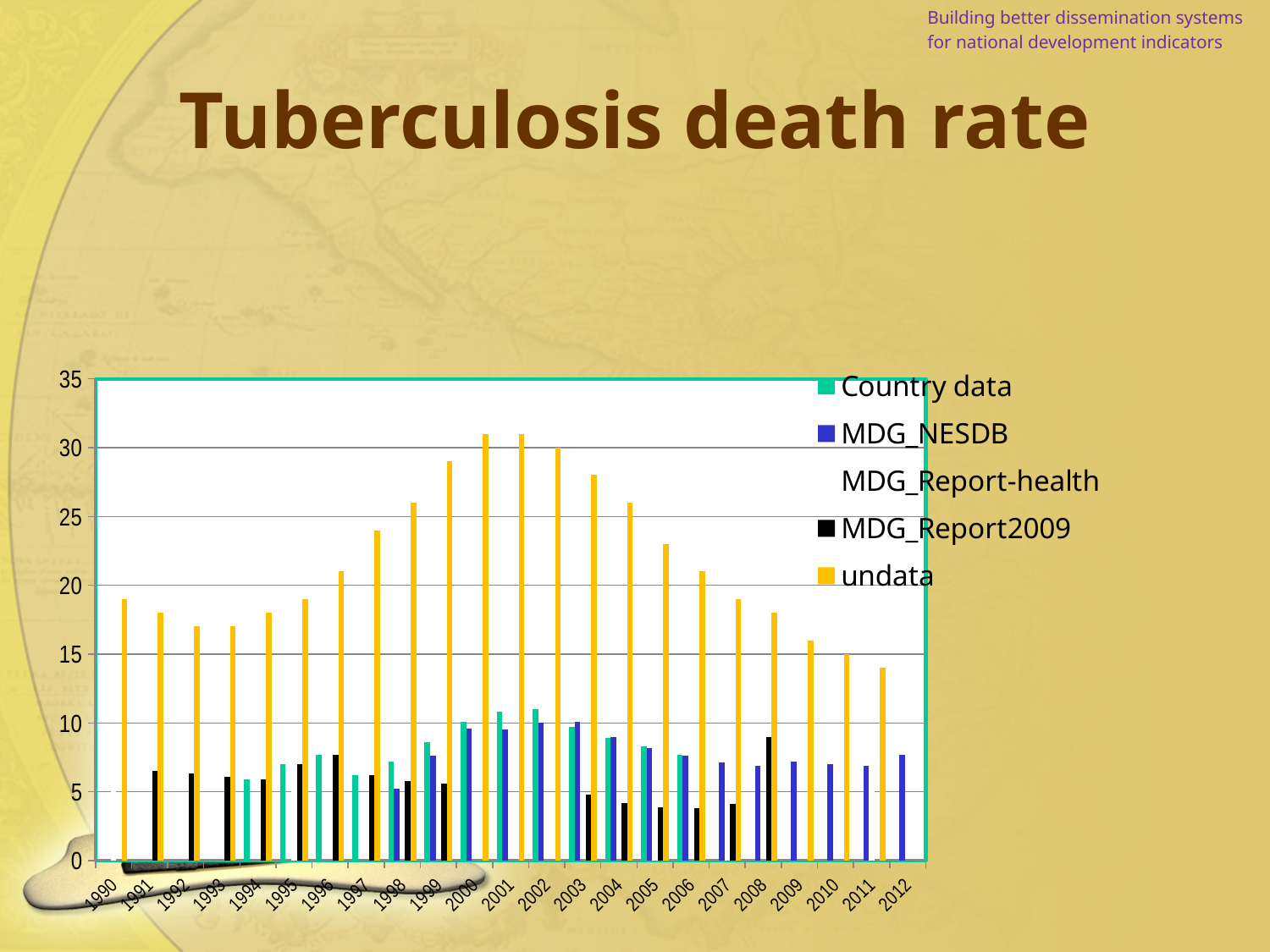
Is the undata value for 1990 greater or less than 20? less What is the title of the chart? Tuberculosis death rate Do the undata values rise or fall from 2001 to 2012? fall Which year has the lowest undata value? 2011 How many series does the legend list? 5 Is the undata value for 1999 greater or less than 30? less Is the MDG_Report2009 value for 2008 greater or less than 5? greater What kind of chart is shown on the slide? bar chart How many years are shown on the x axis? 23 Which is larger in 2008, the undata value or the MDG_Report2009 value? undata Which colour represents the undata series in the legend? yellow